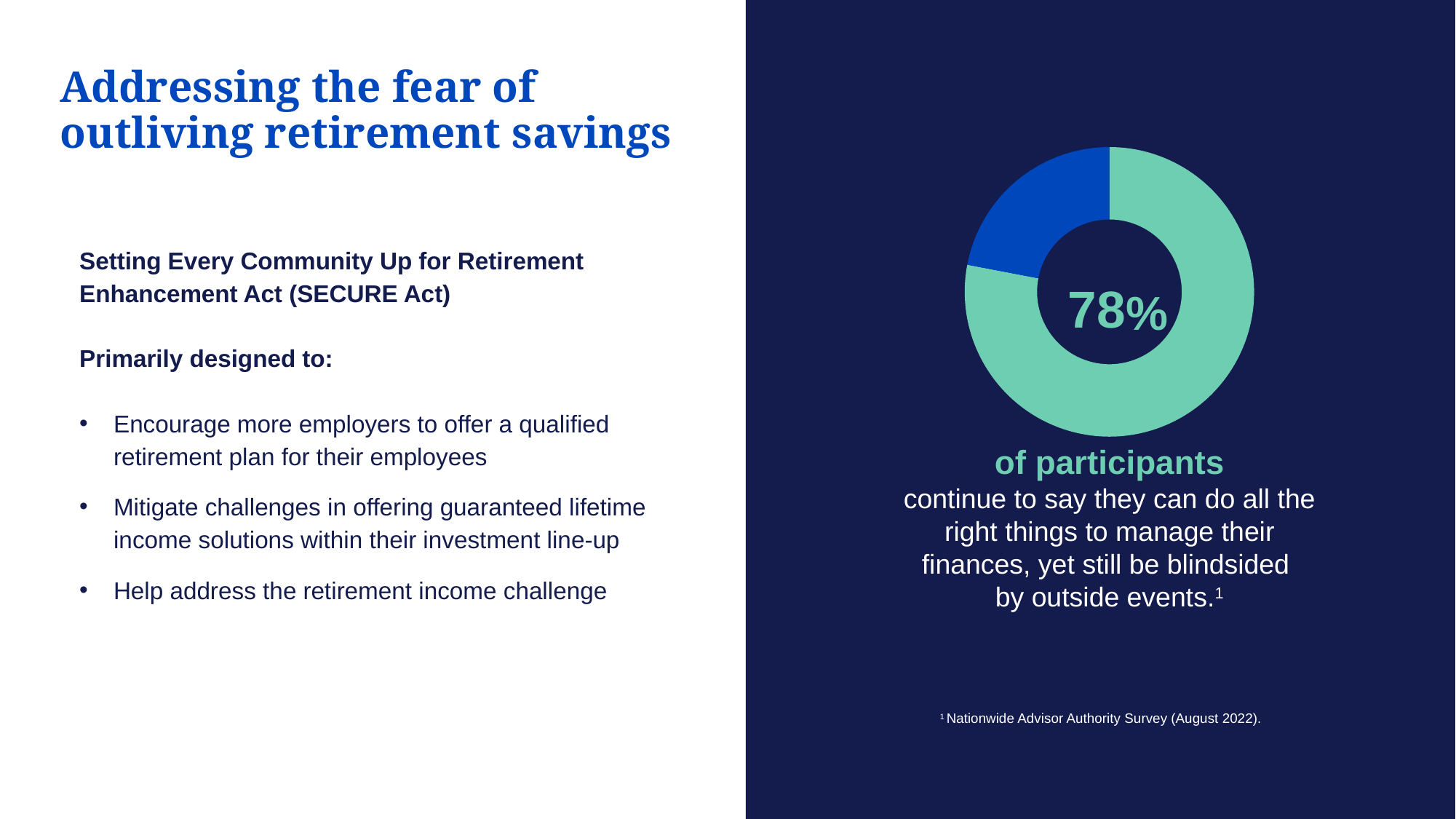
Is the share of the blue slice in the donut chart greater or less than 50%? less What source is cited for the donut chart's statistic? Nationwide Advisor Authority Survey (August 2022) Which slice of the donut chart is larger, the green one or the blue one? the green one What group does the 78% figure in the donut chart refer to? participants What percentage of participants does the donut chart highlight? 78% What share of the donut chart does the blue slice represent? 22% Is the share of the green slice in the donut chart greater or less than 50%? greater What is the share of the largest slice in the donut chart? 78% What kind of chart is shown on the right side of the slide? donut (pie) chart How many slices does the donut chart have? 2 What colour is the slice representing 78% in the donut chart? green